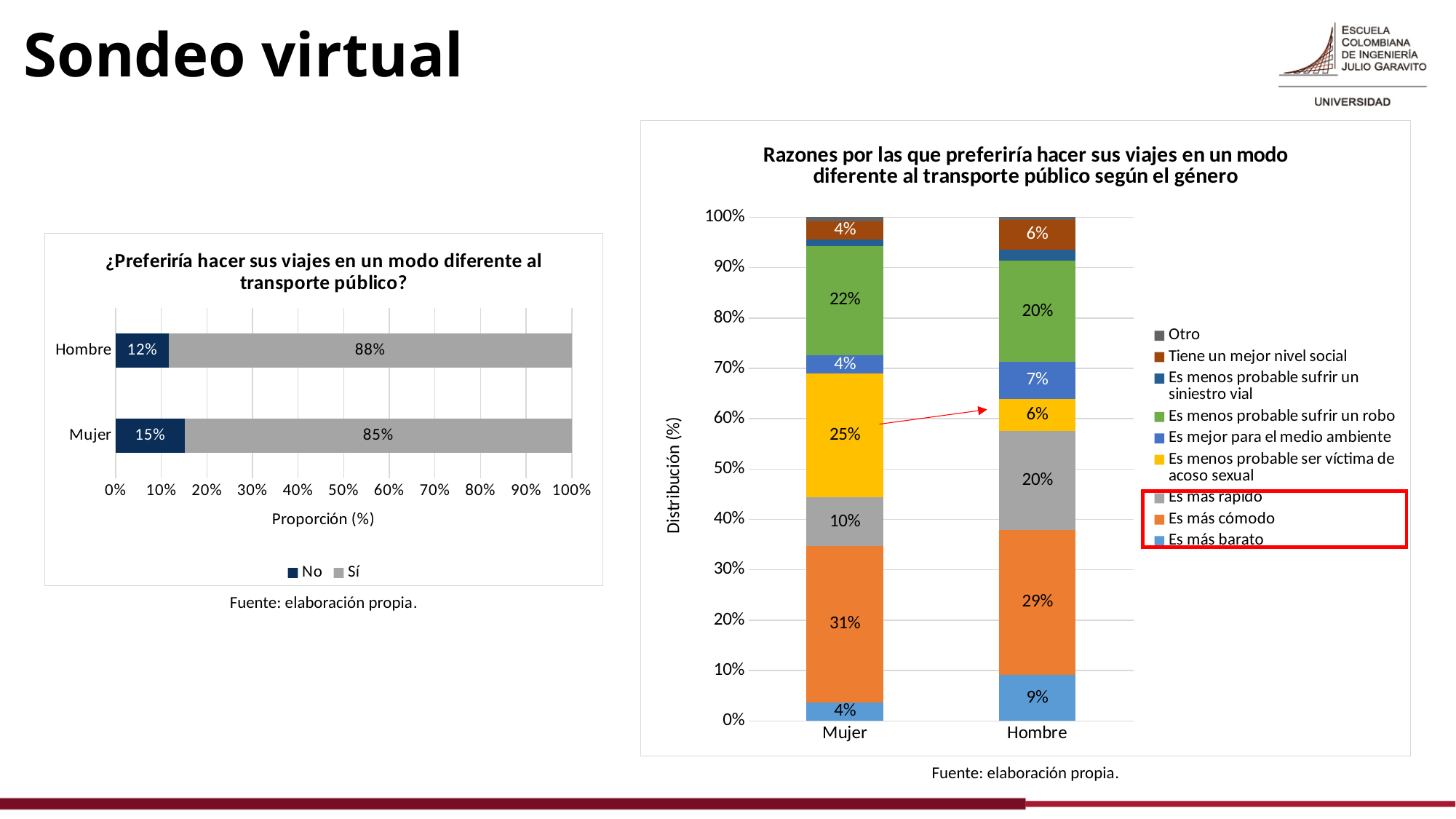
In the left chart '¿Preferiría hacer sus viajes en un modo diferente al transporte público?', which group has the higher No percentage, Hombre or Mujer? Mujer In the left chart '¿Preferiría hacer sus viajes en un modo diferente al transporte público?', what percentage of Hombre answered No? 12% How many series does the legend of the right chart 'Razones por las que preferiría hacer sus viajes en un modo diferente al transporte público según el género' list? 9 In the left chart '¿Preferiría hacer sus viajes en un modo diferente al transporte público?', what percentage of Mujer answered Sí? 85% In the right chart 'Razones por las que preferiría hacer sus viajes en un modo diferente al transporte público según el género', what is the difference between the 'Es menos probable ser víctima de acoso sexual' values for Mujer and Hombre? 19% In the right chart 'Razones por las que preferiría hacer sus viajes en un modo diferente al transporte público según el género', what is the value of 'Es menos probable ser víctima de acoso sexual' for Hombre? 6% What type of chart is the left chart '¿Preferiría hacer sus viajes en un modo diferente al transporte público?'? Stacked bar chart In the right chart 'Razones por las que preferiría hacer sus viajes en un modo diferente al transporte público según el género', which reason has the largest share for Mujer? Es más cómodo In the right chart 'Razones por las que preferiría hacer sus viajes en un modo diferente al transporte público según el género', what is the value of 'Es más rápido' for Hombre? 20% In the left chart '¿Preferiría hacer sus viajes en un modo diferente al transporte público?', what is the difference between the Sí percentages for Hombre and Mujer? 3% In the right chart 'Razones por las que preferiría hacer sus viajes en un modo diferente al transporte público según el género', what is the value of 'Es más cómodo' for Mujer? 31% In the right chart 'Razones por las que preferiría hacer sus viajes en un modo diferente al transporte público según el género', which legend entries are outlined with a red box? Es más rápido, Es más cómodo, Es más barato